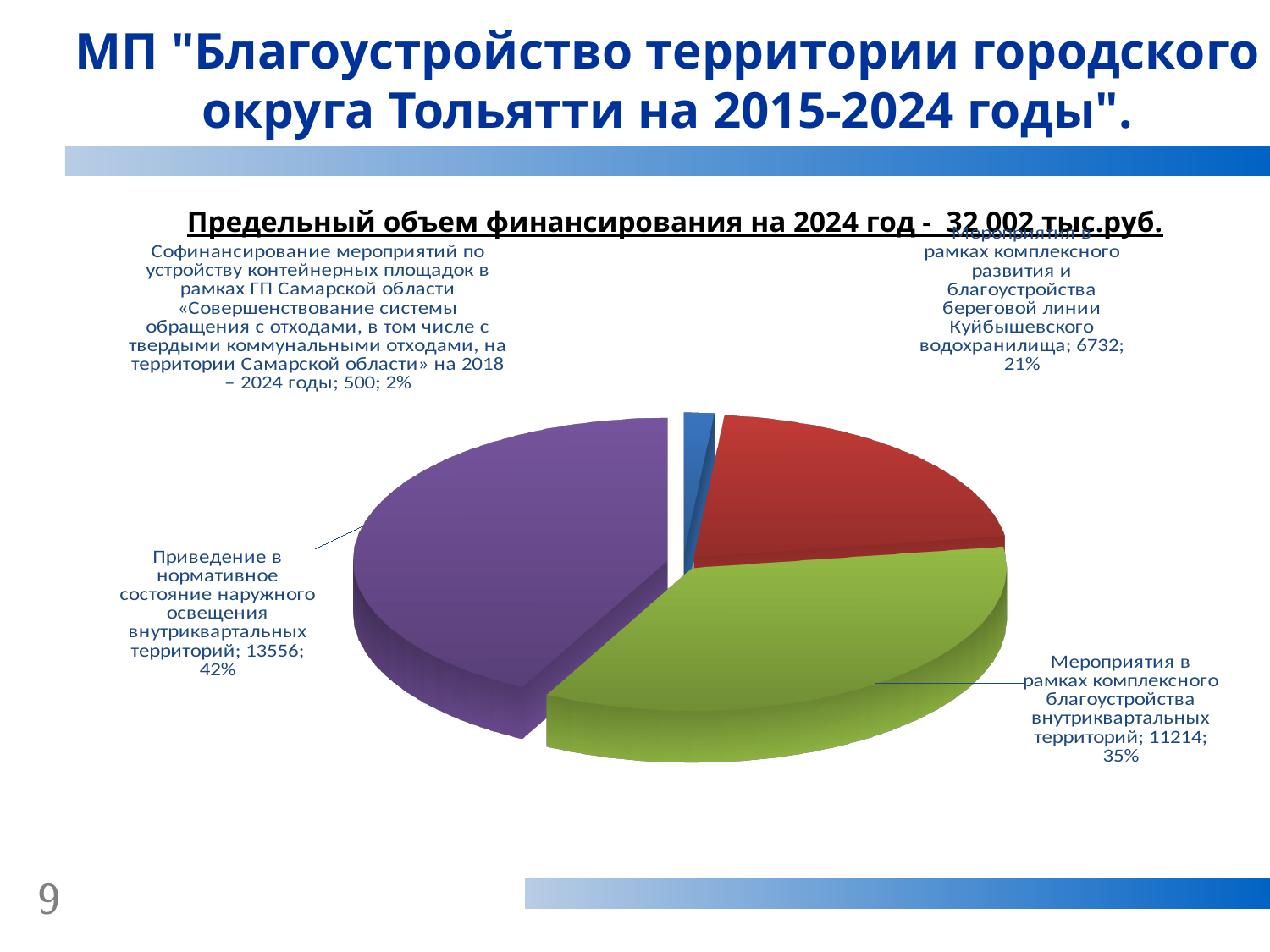
What total funding amount for 2024 is stated in the chart title? 32 002 тыс.руб. Which category has the largest slice of the pie? Приведение в нормативное состояние наружного освещения внутриквартальных территорий What share of the pie does "Софинансирование мероприятий по устройству контейнерных площадок" represent? 2% What is the value for "Мероприятия в рамках комплексного благоустройства внутриквартальных территорий"? 11214 How many slices does the pie chart have? 4 What type of chart is shown on the slide? Pie chart What is the difference between the values for "Приведение в нормативное состояние наружного освещения внутриквартальных территорий" and "Мероприятия в рамках комплексного благоустройства внутриквартальных территорий"? 2342 Which category has the smallest slice of the pie? Софинансирование мероприятий по устройству контейнерных площадок What share of the pie does "Мероприятия в рамках комплексного развития и благоустройства береговой линии Куйбышевского водохранилища" represent? 21% Which is larger: the value for "Мероприятия в рамках комплексного благоустройства внутриквартальных территорий" or for "Мероприятия в рамках комплексного развития и благоустройства береговой линии Куйбышевского водохранилища"? Мероприятия в рамках комплексного благоустройства внутриквартальных территорий What is the value for "Мероприятия в рамках комплексного развития и благоустройства береговой линии Куйбышевского водохранилища"? 6732 What is the value for "Приведение в нормативное состояние наружного освещения внутриквартальных территорий"? 13556